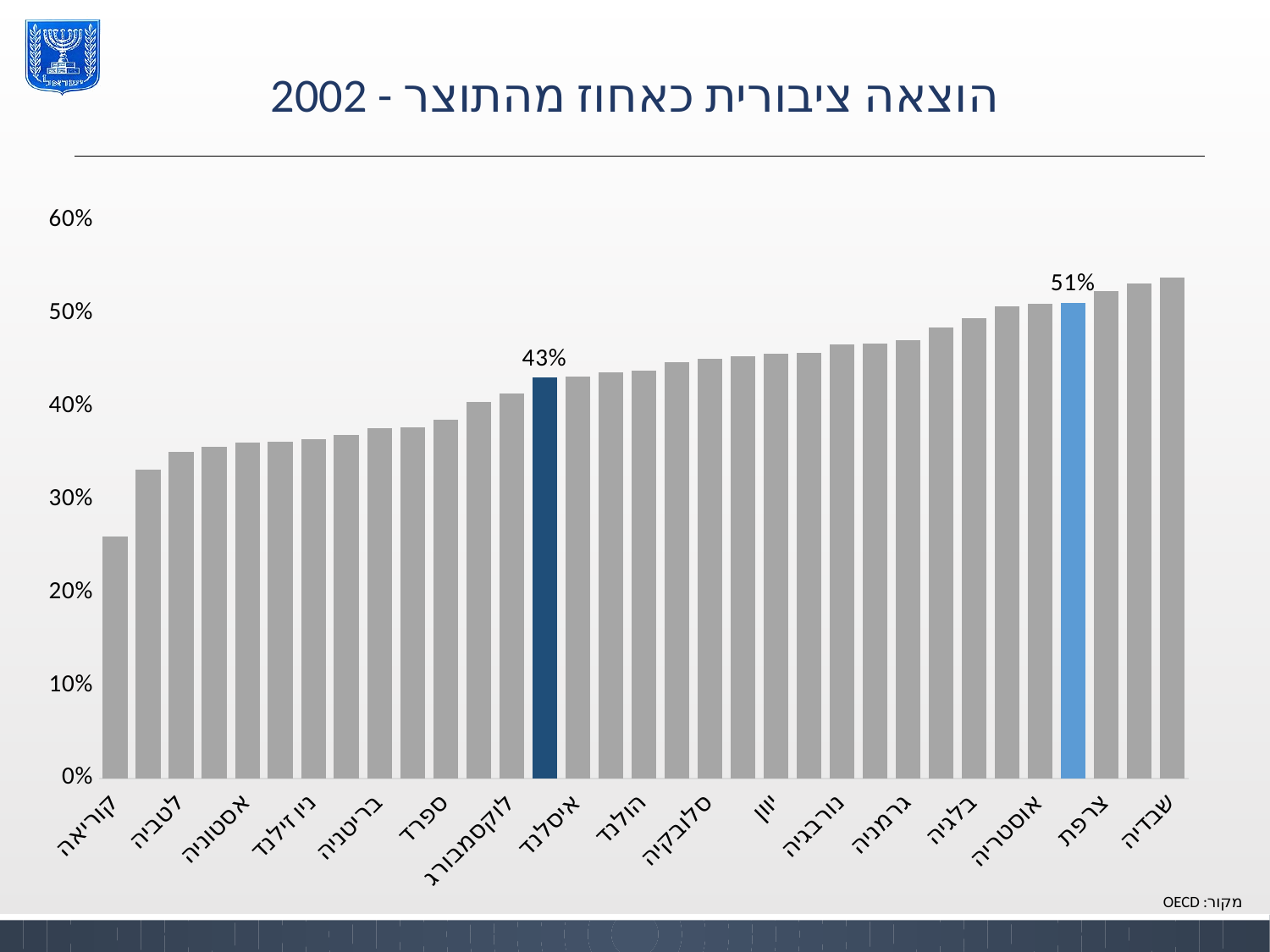
Is the value for קוריאה greater or less than 30%? less What source is cited at the bottom of the slide? OECD Which country has the highest value in the chart? שבדיה Which is larger, the dark blue bar or the light blue bar? the light blue bar What is the title of the chart? הוצאה ציבורית כאחוז מהתוצר - 2002 What value is labelled on the dark blue bar? 43% What is the difference between the light blue bar (51%) and the dark blue bar (43%)? 8 percentage points Do the values rise or fall from left to right along the x axis? rise Is the value for שבדיה greater or less than 50%? greater Which country has the lowest value in the chart? קוריאה What value is labelled on the light blue bar? 51% What kind of chart is shown on the slide? bar chart